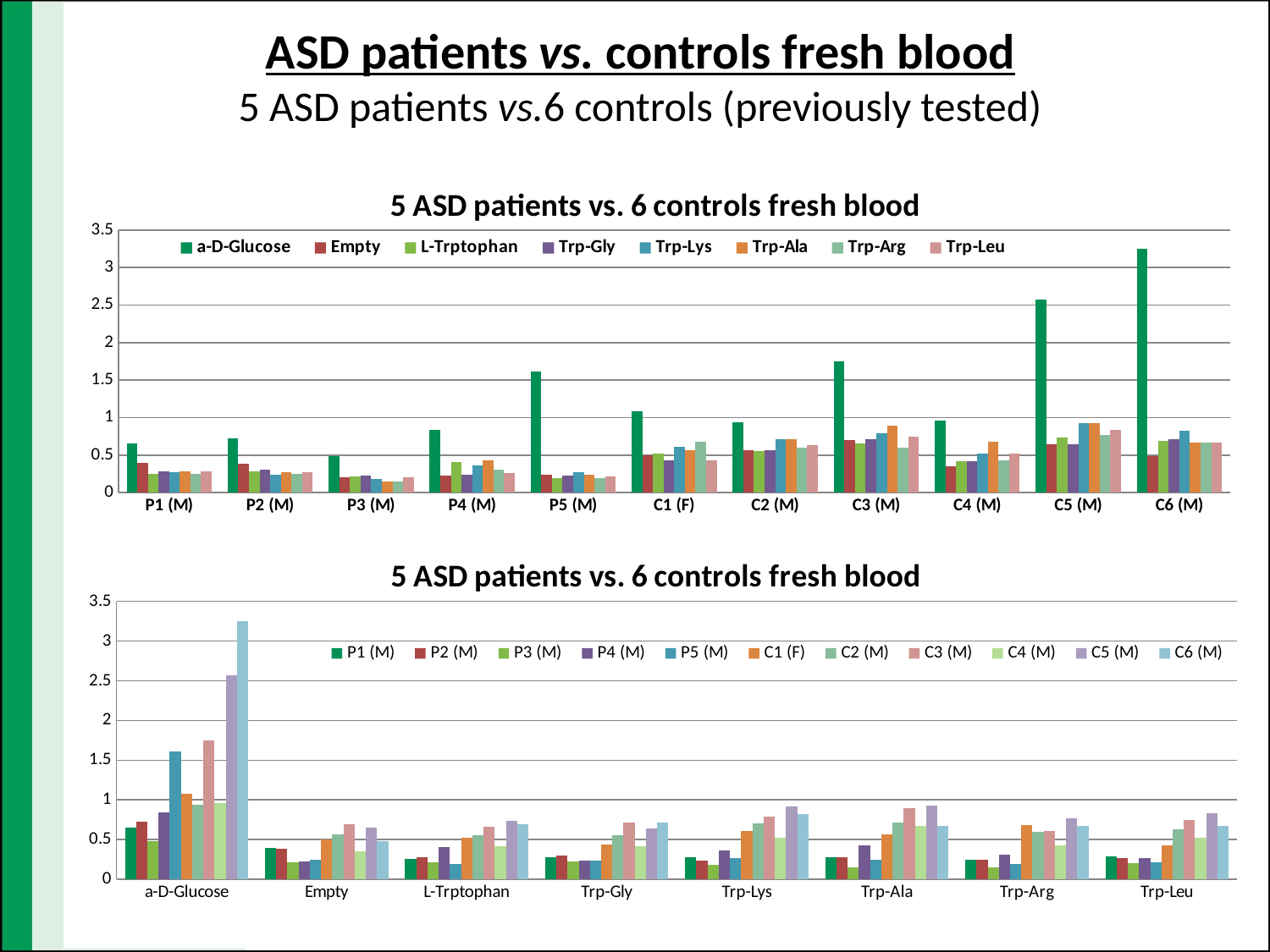
In the bottom chart, which is larger: the a-D-Glucose value for P5 (M) or for C1 (F)? P5 (M) How many series does the legend of the bottom chart list? 11 How many categories are shown on the x axis of the top chart? 11 In the top chart, which is larger: the a-D-Glucose value for C5 (M) or for C6 (M)? C6 (M) What is the title of the bottom chart? 5 ASD patients vs. 6 controls fresh blood In the top chart, is the a-D-Glucose value for C6 (M) greater or less than 3? greater What kind of chart is the top chart on the slide? bar chart In the top chart, is the a-D-Glucose value for P5 (M) greater or less than 1? greater How many series does the legend of the top chart list? 8 In the top chart, which category has the highest a-D-Glucose bar? C6 (M) How many categories are shown on the x axis of the bottom chart? 8 In the top chart, which category has the lowest a-D-Glucose bar? P3 (M)